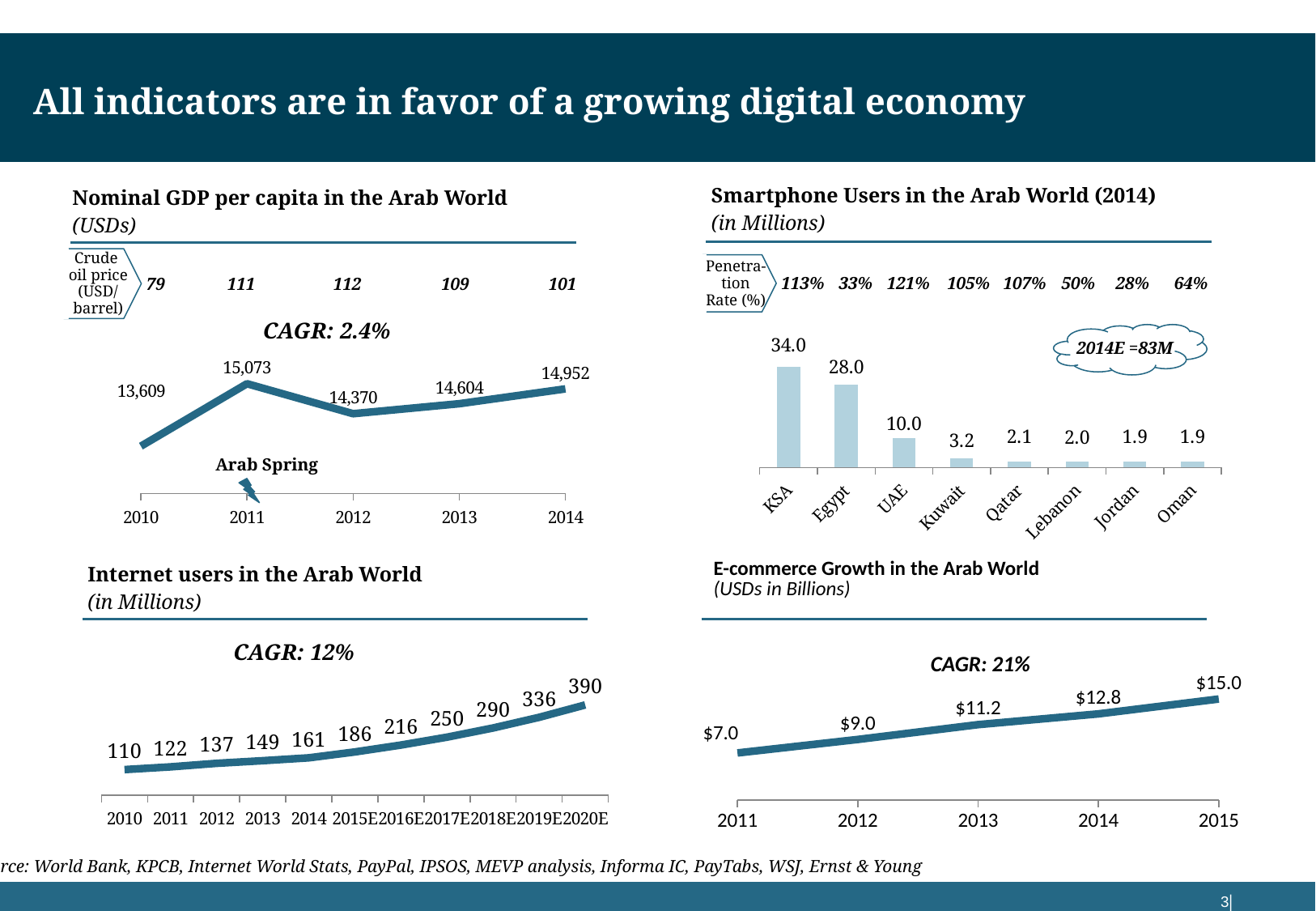
In the Smartphone Users in the Arab World (2014) chart, what is the value for Egypt? 28.0 In the Nominal GDP per capita in the Arab World chart, what is the difference between the 2014 and 2010 values? 1,343 In the Smartphone Users in the Arab World (2014) chart, which is larger, the value for UAE or the value for Kuwait? UAE In the Nominal GDP per capita in the Arab World chart, which year has the lowest value? 2010 In the E-commerce Growth in the Arab World chart, what is the difference between the 2015 and 2011 values? $8.0 How many countries are shown in the Smartphone Users in the Arab World (2014) chart? 8 In the Smartphone Users in the Arab World (2014) chart, which country has the highest value? KSA In the E-commerce Growth in the Arab World chart, what is the value for 2013? $11.2 What kind of chart is the Smartphone Users in the Arab World (2014) chart? Bar chart In the Internet users in the Arab World chart, what is the value for 2017E? 250 In the Nominal GDP per capita in the Arab World chart, what is the value for 2011? 15,073 In the Internet users in the Arab World chart, do the values rise or fall from 2010 to 2020E? Rise